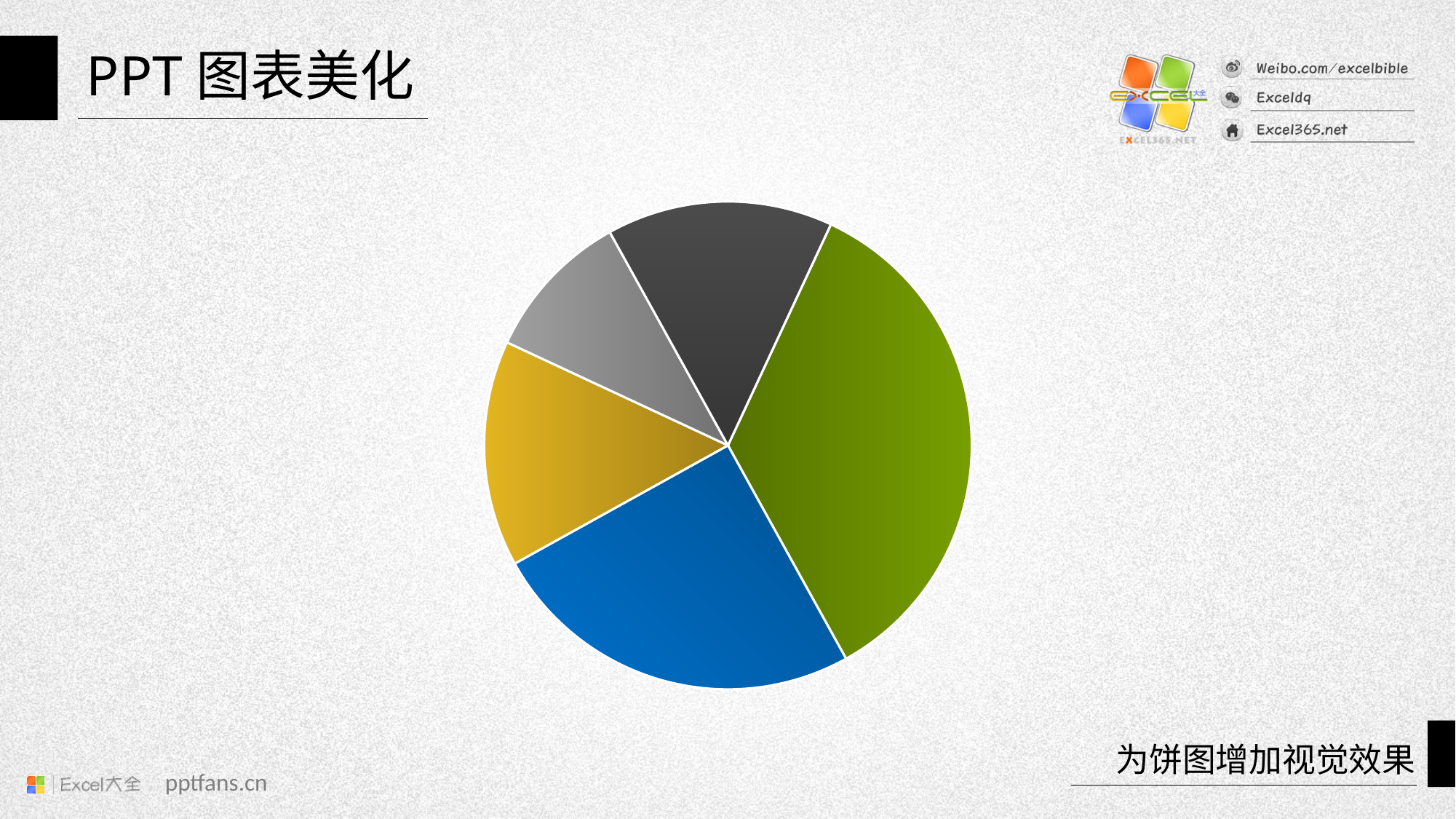
Which is larger in the pie chart, the blue slice or the yellow slice? blue Does the pie chart show a legend? No Which colour slice is the smallest in the pie chart? light grey How many slices does the pie chart have? 5 Which is larger in the pie chart, the green slice or the blue slice? green What kind of chart is shown on the slide? pie chart Which is larger in the pie chart, the dark grey slice or the light grey slice? dark grey What is the title text at the top left of the slide? PPT 图表美化 Which colour slice is the largest in the pie chart? green